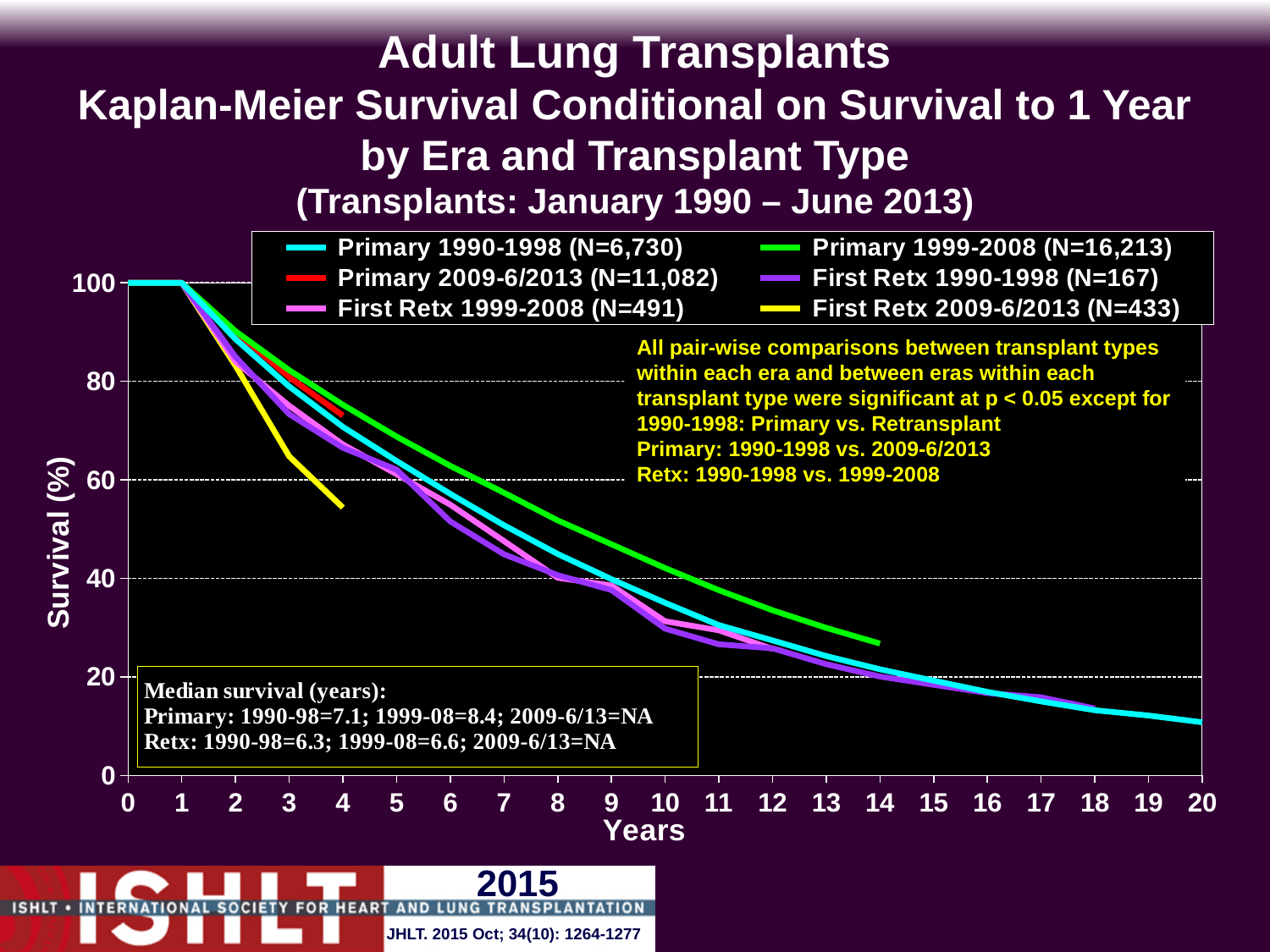
According to the text box, what is the median survival in years for Primary transplants in 1999-08? 8.4 Do the survival curves rise or fall as years increase along the x axis? fall What kind of chart is shown on the slide? line chart At 10 years, which has higher survival: Primary 1999-2008 or Primary 1990-1998? Primary 1999-2008 Is the survival value for Primary 1990-1998 at 20 years greater or less than 20? less According to the text box, what is the median survival in years for Retx in 1990-98? 6.3 Is the survival value for Primary 1999-2008 at 14 years greater or less than 20? greater Is the survival value for First Retx 2009-6/2013 at 4 years greater or less than 60? less Which series extends furthest along the x axis, reaching 20 years? Primary 1990-1998 How many series does the legend list? 6 What is the N shown in the legend for Primary 1999-2008? 16,213